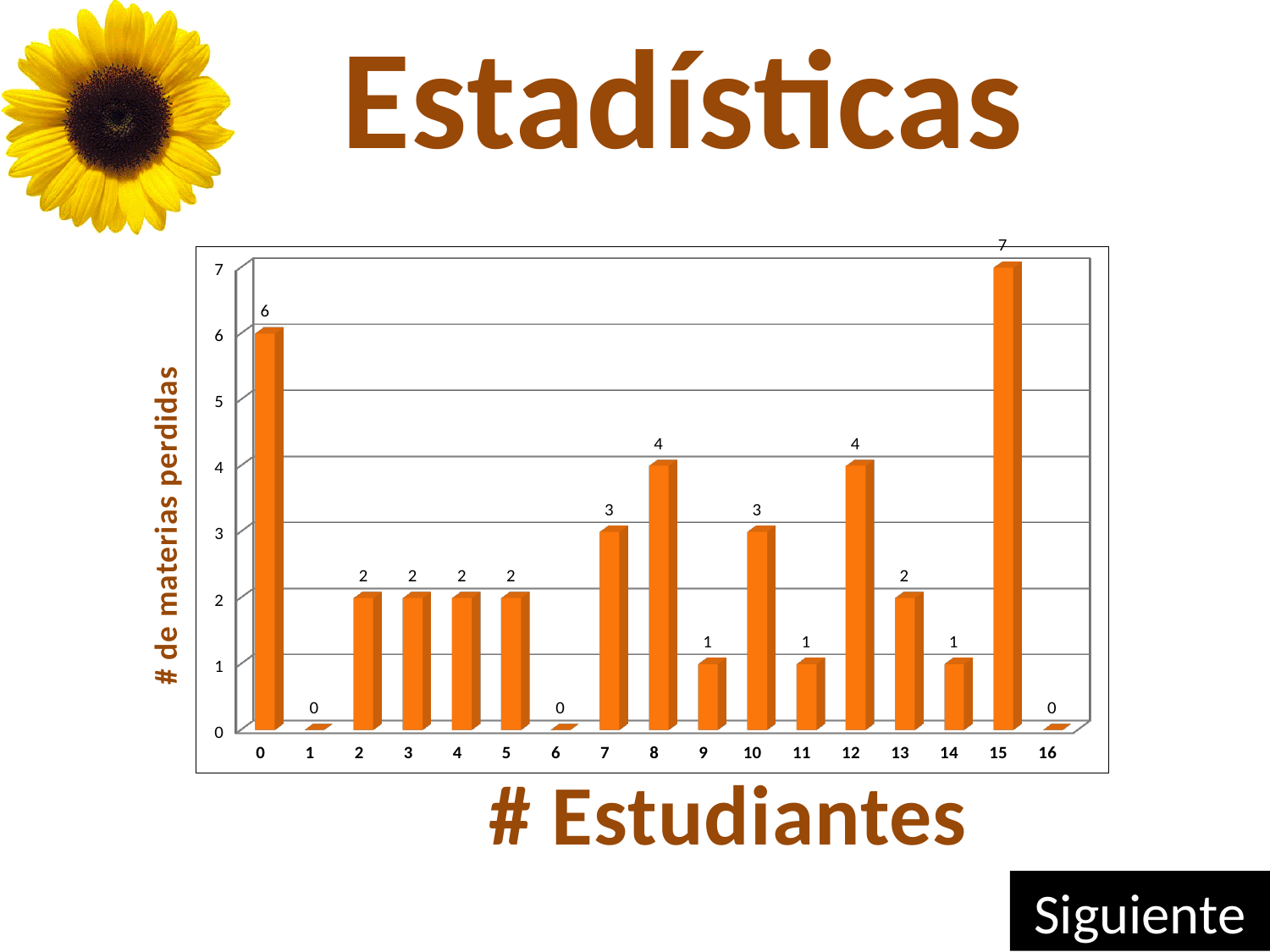
What is the highest value shown in the chart? 7 What is the value for category 8? 4 What is the difference between the values for category 15 and category 0? 1 What kind of chart is shown on the slide? bar chart What is the value for category 13? 2 Which category has the highest value? 15 What is the value for category 0? 6 What is the label of the vertical axis? # de materias perdidas Which is larger, the value for category 7 or the value for category 11? 7 How many categories are shown on the x axis? 17 How many categories have a value of 0? 3 What is the difference between the values for category 12 and category 9? 3